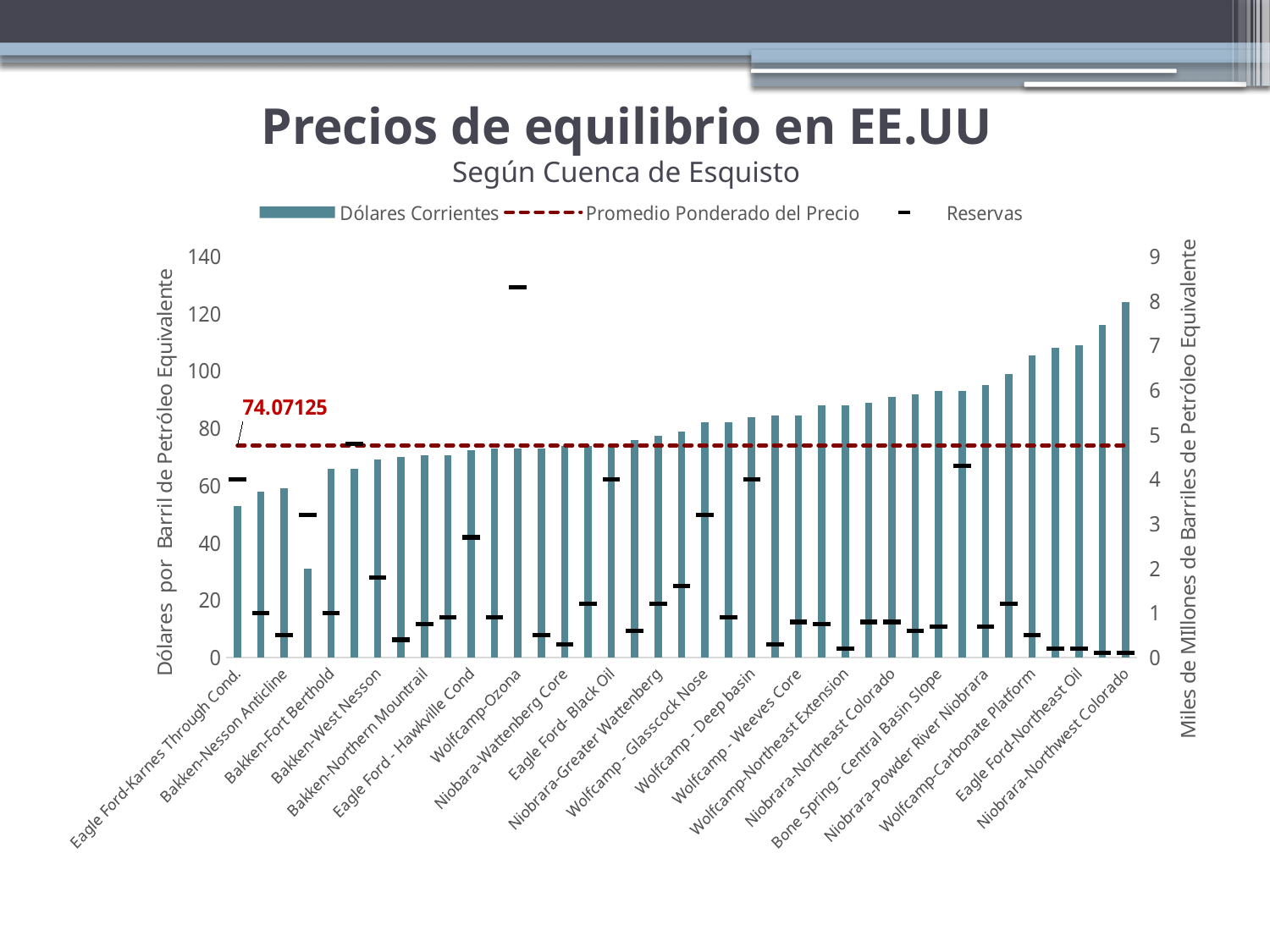
What kind of chart is used for the Dólares Corrientes series? Bar chart Which category has the highest Dólares Corrientes bar? Niobrara-Northwest Colorado Is the Dólares Corrientes value for Eagle Ford-Karnes Through Cond. greater or less than the Promedio Ponderado del Precio line of 74.07125? less What is the label of the right-hand vertical axis? Miles de MIllones de Barriles de Petróleo Equivalente Is the Dólares Corrientes value for Eagle Ford-Karnes Through Cond. greater or less than 60? less What is the value of the Promedio Ponderado del Precio line shown on the chart? 74.07125 Do the Dólares Corrientes bars rise or fall from left to right along the x axis? Rise Is the Dólares Corrientes value for Niobrara-Northwest Colorado greater or less than 120? greater What is the title of the chart? Precios de equilibrio en EE.UU Which has the larger Dólares Corrientes value, Eagle Ford-Karnes Through Cond. or Niobrara-Northwest Colorado? Niobrara-Northwest Colorado How many series does the chart legend list? 3